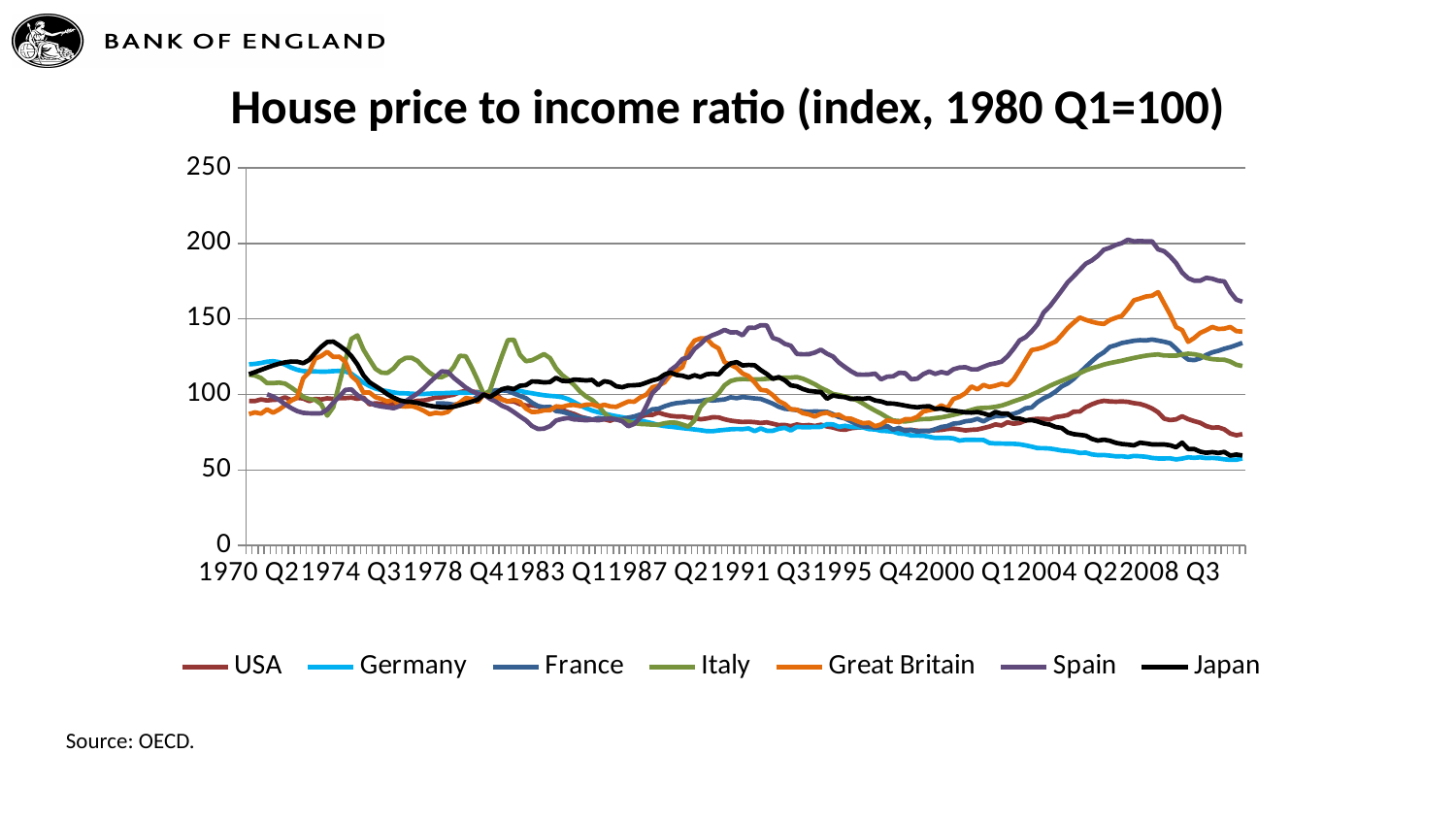
Is the peak value for Great Britain greater or less than 150? greater What kind of chart is shown on the slide? Line chart Is the peak value for Spain greater or less than 150? greater Is the value for Germany at the end of the series greater or less than 100? less Which series reaches the highest value on the chart? Spain Does the Germany series generally rise or fall from 1970 to the end of the chart? Fall Which series has the highest value at the right-hand end of the chart? Spain What is the title of the chart? House price to income ratio (index, 1980 Q1=100) How many series does the legend list? 7 What source is cited for the chart data? OECD Does the Spain series rise or fall between 2000 Q1 and 2008 Q3? Rise